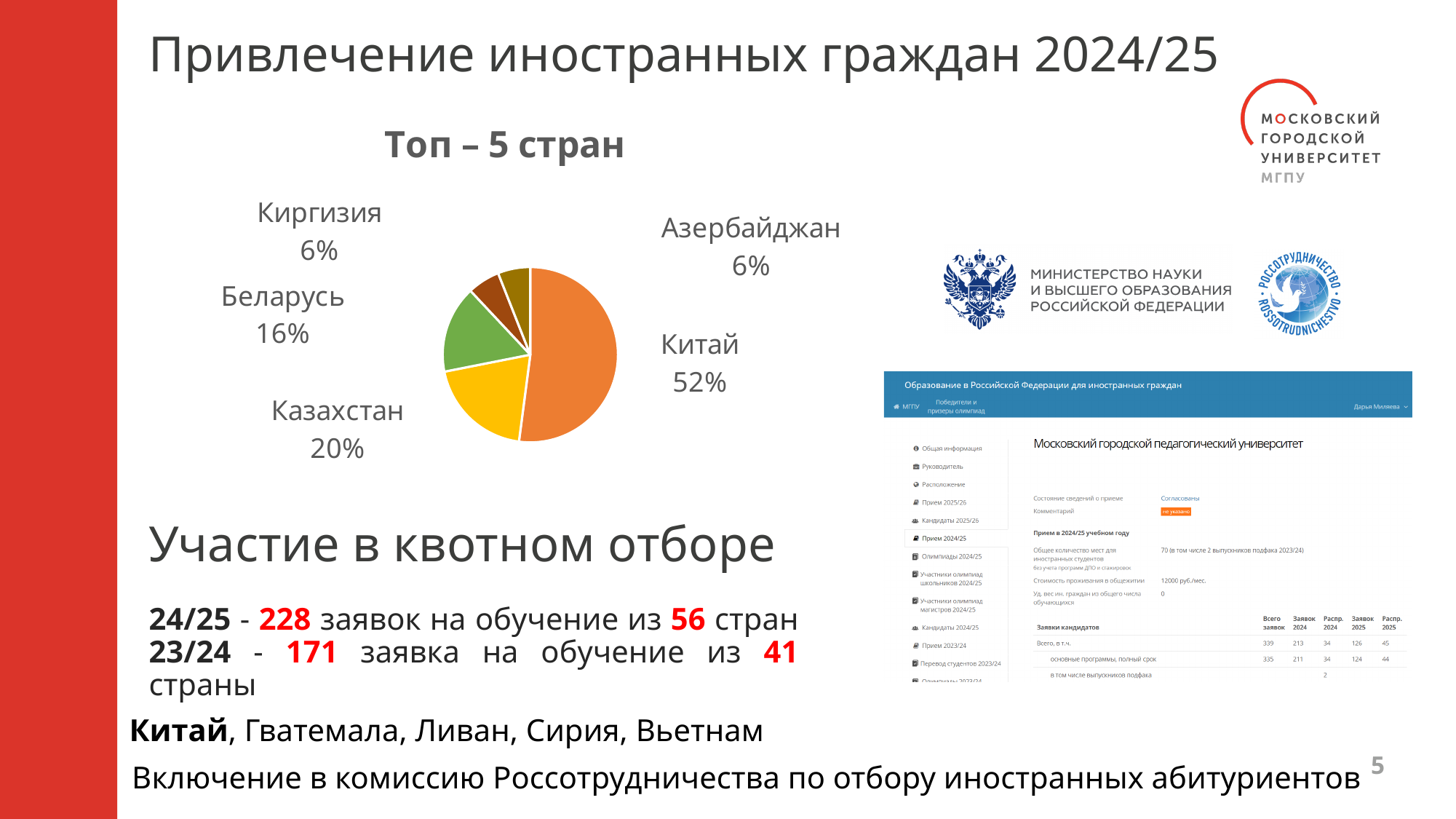
What share of the pie chart does Казахстан have? 20% What kind of chart is shown under the heading "Топ – 5 стран"? pie chart Which two countries in the pie chart have the same share? Киргизия and Азербайджан What share of the pie chart does Азербайджан have? 6% How many countries (slices) are shown in the pie chart? 5 Which country has the largest slice in the pie chart? Китай What share of the pie chart does Беларусь have? 16% By how many percentage points does the share of Китай exceed the share of Казахстан in the pie chart? 32 percentage points What share of the pie chart does Киргизия have? 6% What share of the pie chart does Китай have? 52% What is the title of the pie chart? Топ – 5 стран Which has a larger share in the pie chart, Казахстан or Беларусь? Казахстан